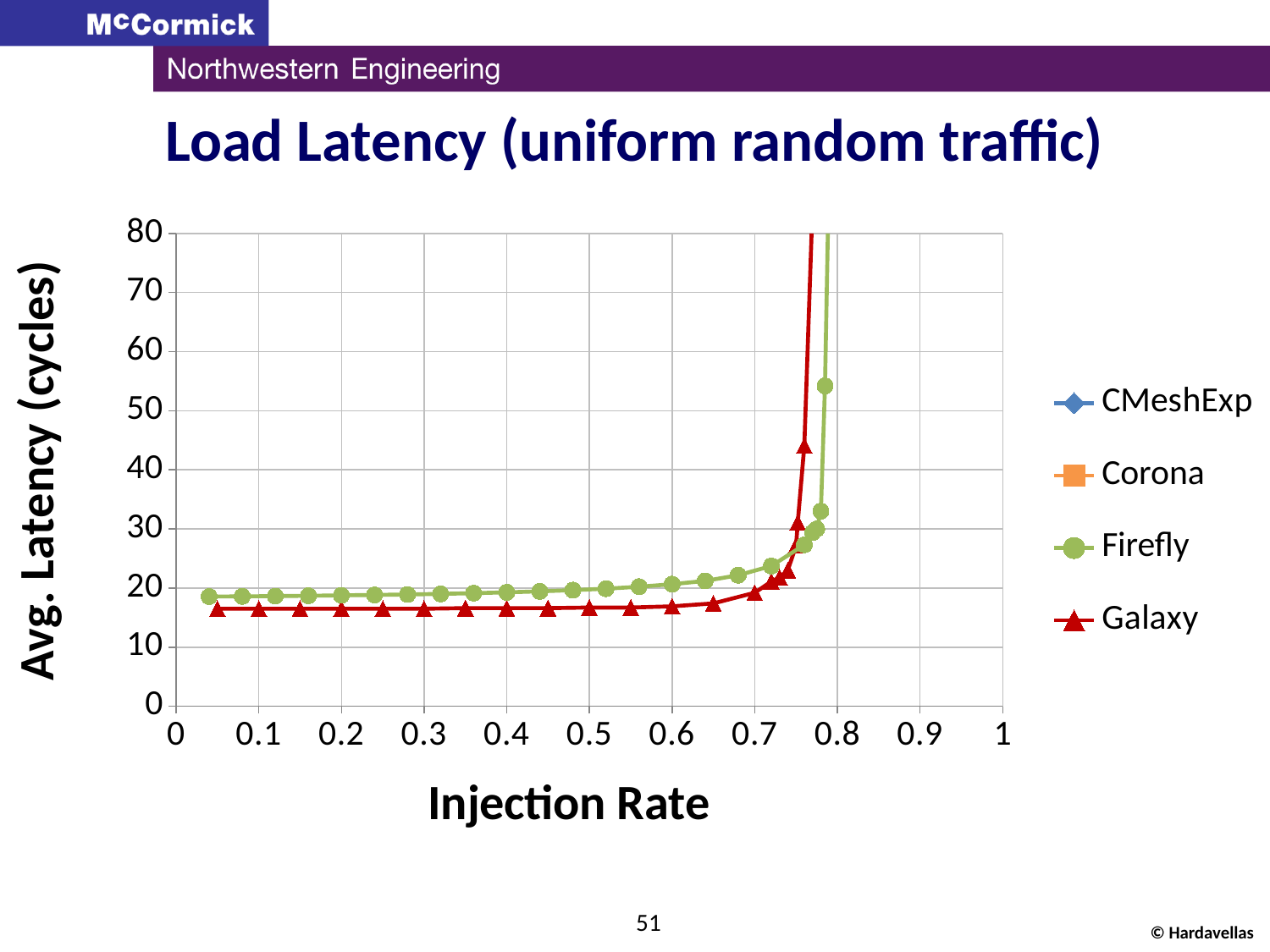
At injection rate 0.4, which series has the higher average latency, Firefly or Galaxy? Firefly How many series does the legend list? 4 What is the label of the y axis? Avg. Latency (cycles) Does the average latency for Galaxy rise or fall as the injection rate increases? rise What kind of chart is shown on the slide? line chart Is the highest plotted Firefly point greater or less than 50? greater Is the value for Galaxy at injection rate 0.5 greater or less than 30? less Which series shoots up toward 80 cycles at a lower injection rate, Firefly or Galaxy? Galaxy Which series is plotted with red triangle markers? Galaxy Is the value for Firefly at injection rate 0.7 greater or less than 20? greater What is the title of the chart? Load Latency (uniform random traffic)